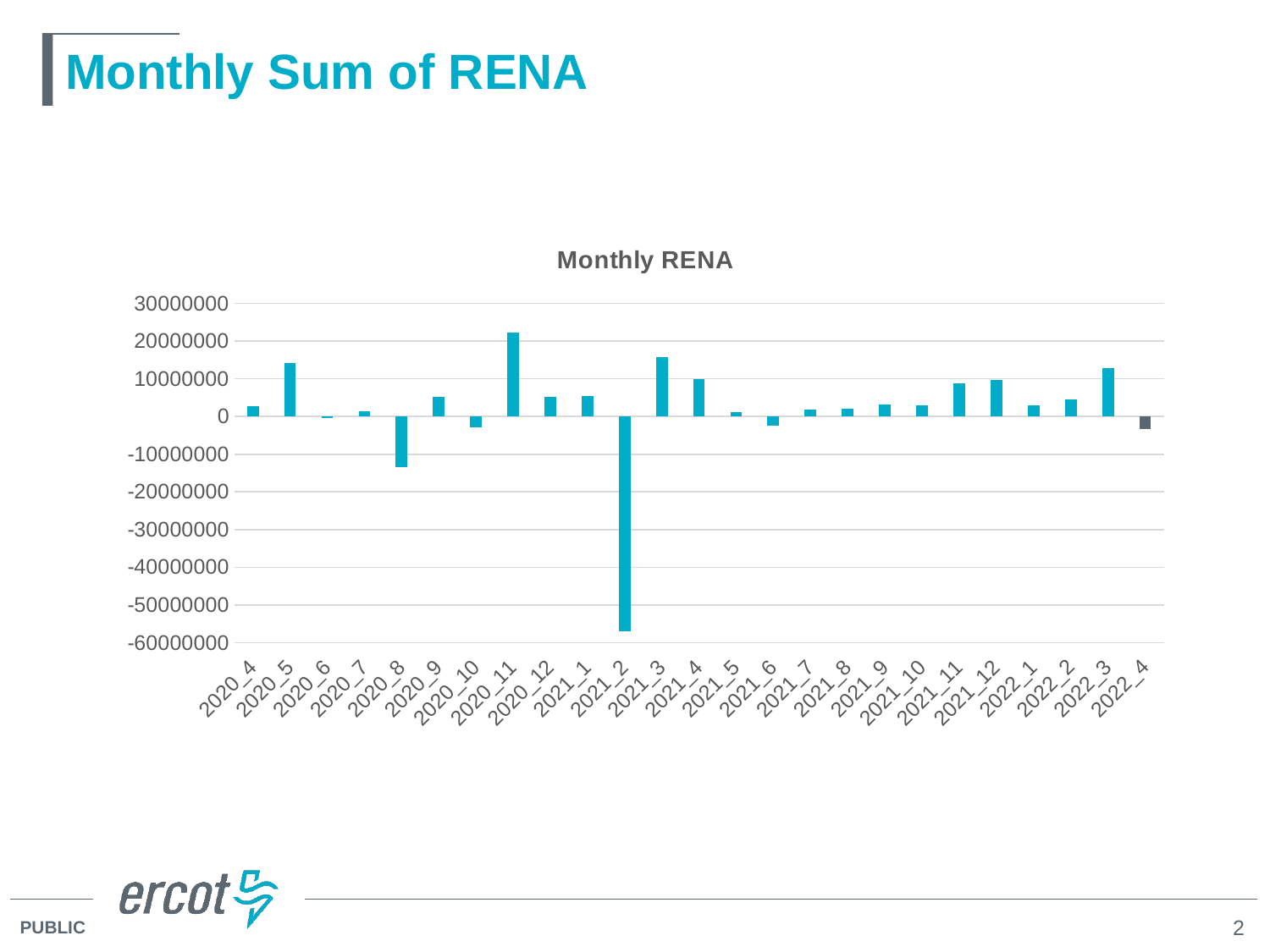
What is the title of the chart? Monthly RENA Which month has the highest value? 2020_11 Which month has the lowest value? 2021_2 What kind of chart is shown on the slide? bar chart Is the value for 2020_8 greater or less than -10000000? less Is the value for 2021_3 greater or less than 10000000? greater How many months are plotted on the x axis? 25 Is the value for 2020_5 greater or less than 10000000? greater Which bar is drawn in a different colour from the rest? 2022_4 Which is larger, the value for 2020_11 or the value for 2021_3? 2020_11